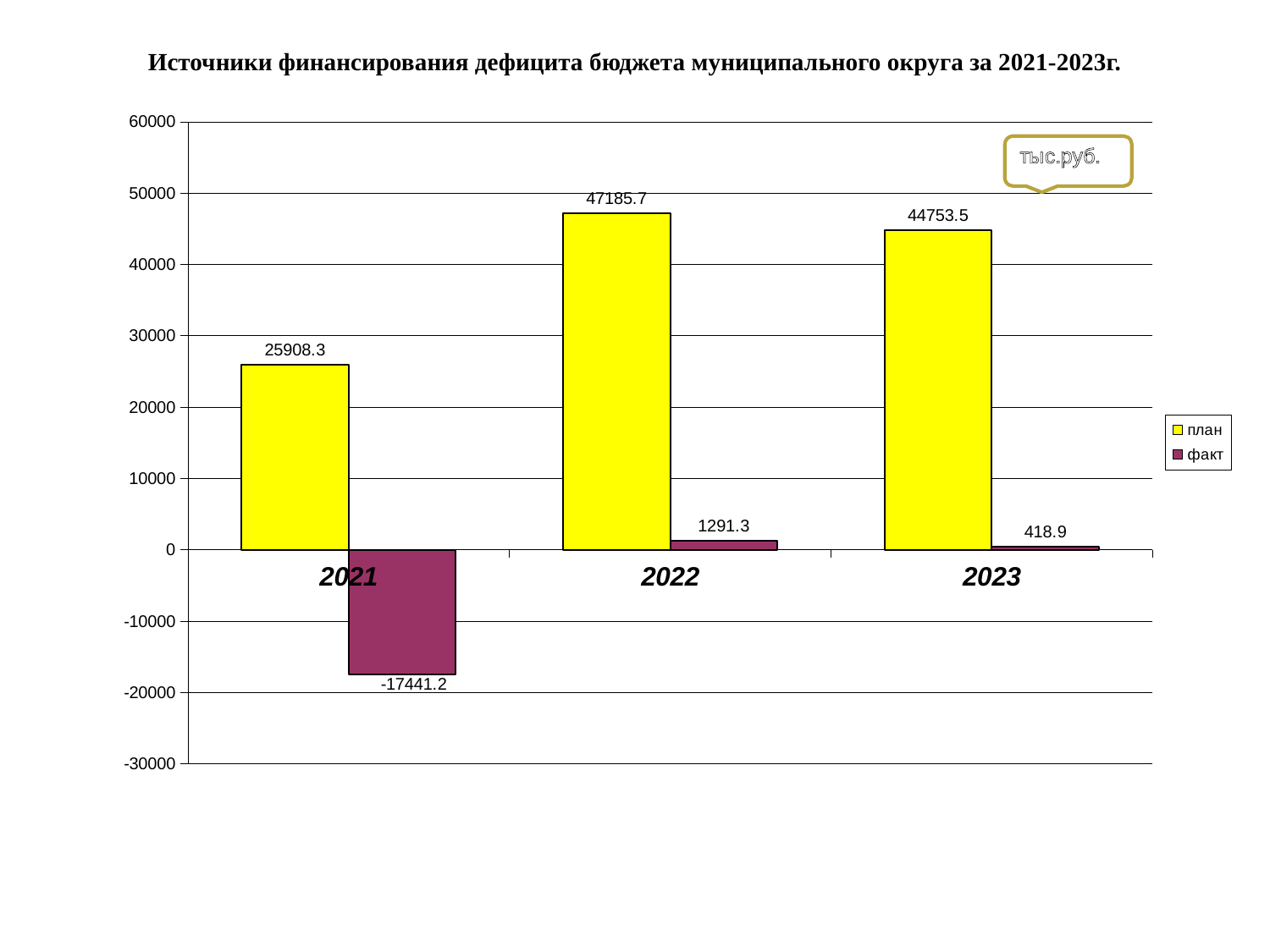
Which is larger, the план value for 2022 or the план value for 2023? 2022 What is the план value for 2022? 47185.7 What is the difference between the факт values for 2022 and 2023? 872.4 Which year has the highest план value? 2022 What is the факт value for 2023? 418.9 Which year has the lowest факт value? 2021 What is the факт value for 2021? -17441.2 How many years are shown on the x axis? 3 What is the difference between the план values for 2022 and 2021? 21277.4 What kind of chart is shown on the slide? bar chart What is the план value for 2021? 25908.3 How many series does the legend list? 2